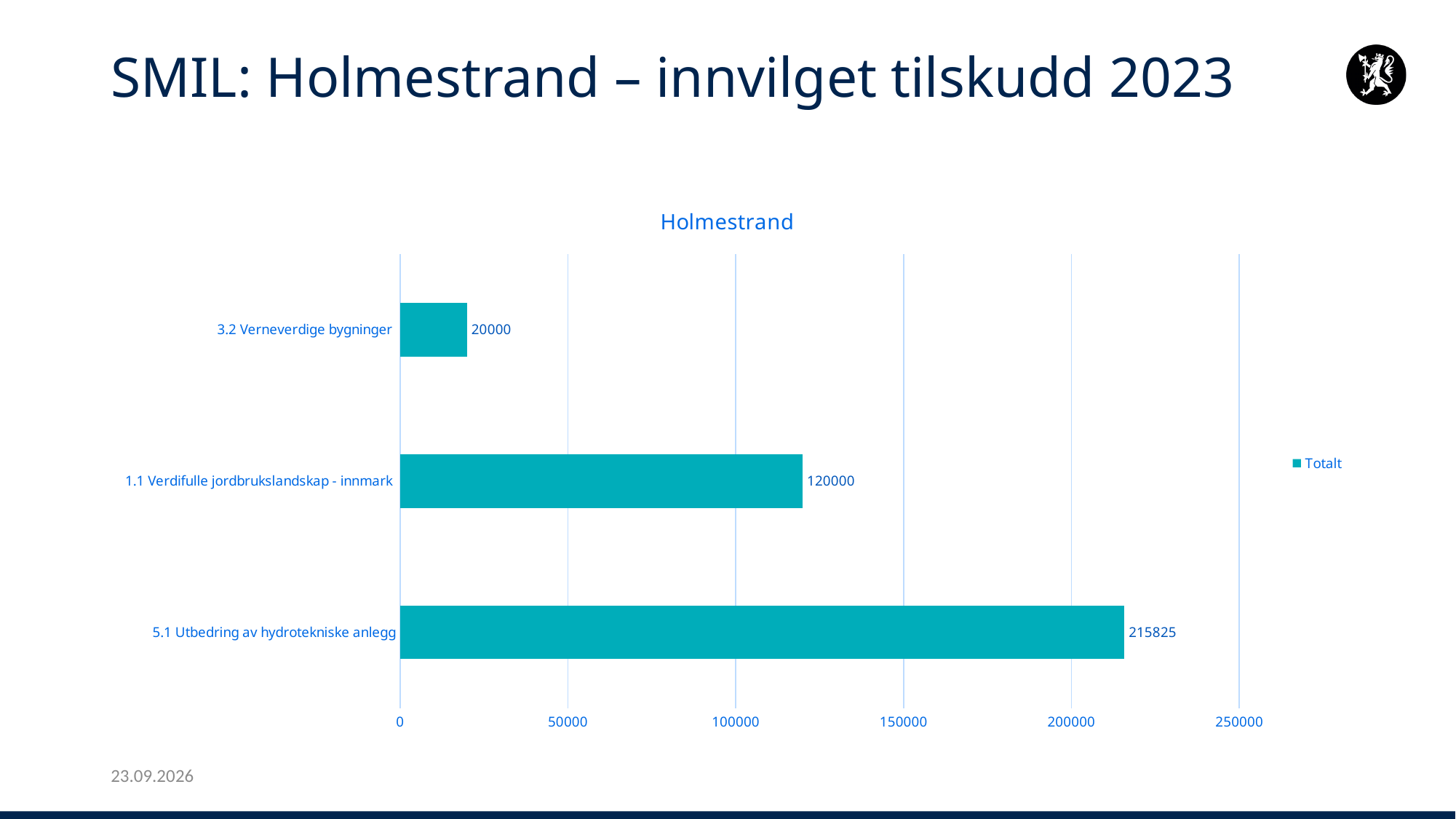
What is the title of the chart? Holmestrand Which is larger, the value for 1.1 Verdifulle jordbrukslandskap - innmark or the value for 3.2 Verneverdige bygninger? 1.1 Verdifulle jordbrukslandskap - innmark What is the value for 1.1 Verdifulle jordbrukslandskap - innmark? 120000 What is the difference between the values for 5.1 Utbedring av hydrotekniske anlegg and 1.1 Verdifulle jordbrukslandskap - innmark? 95825 Which category has the lowest value? 3.2 Verneverdige bygninger How many categories are shown in the chart? 3 Which category has the highest value? 5.1 Utbedring av hydrotekniske anlegg What is the value for 5.1 Utbedring av hydrotekniske anlegg? 215825 What is the value for 3.2 Verneverdige bygninger? 20000 What is the difference between the values for 1.1 Verdifulle jordbrukslandskap - innmark and 3.2 Verneverdige bygninger? 100000 Is the value for 5.1 Utbedring av hydrotekniske anlegg greater or less than 200000? greater What kind of chart is shown on the slide? bar chart